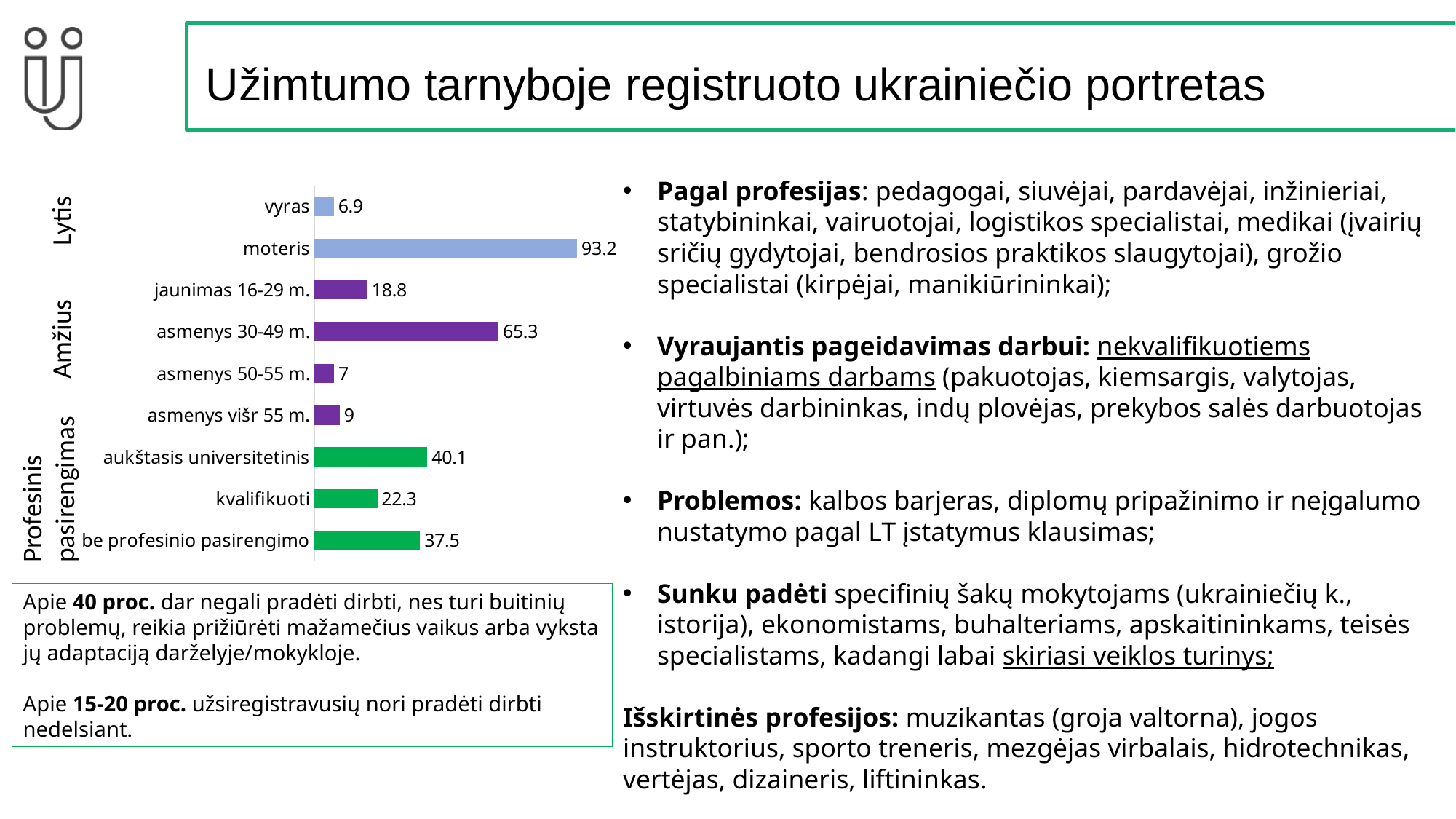
Which category has the lowest value in the chart? vyras How many categories (bars) are shown in the chart? 9 What is the value for moteris? 93.2 What kind of chart is shown on the slide? bar chart Which category has the highest value in the chart? moteris What is the value for kvalifikuoti? 22.3 What is the difference between the values for aukštasis universitetinis and be profesinio pasirengimo? 2.6 What is the difference between the values for moteris and vyras? 86.3 What is the value for asmenys 30-49 m.? 65.3 What are the three group labels shown along the left side of the chart? Lytis, Amžius, Profesinis pasirengimas Which is larger, the value for jaunimas 16-29 m. or the value for asmenys višr 55 m.? jaunimas 16-29 m. What is the value for aukštasis universitetinis? 40.1